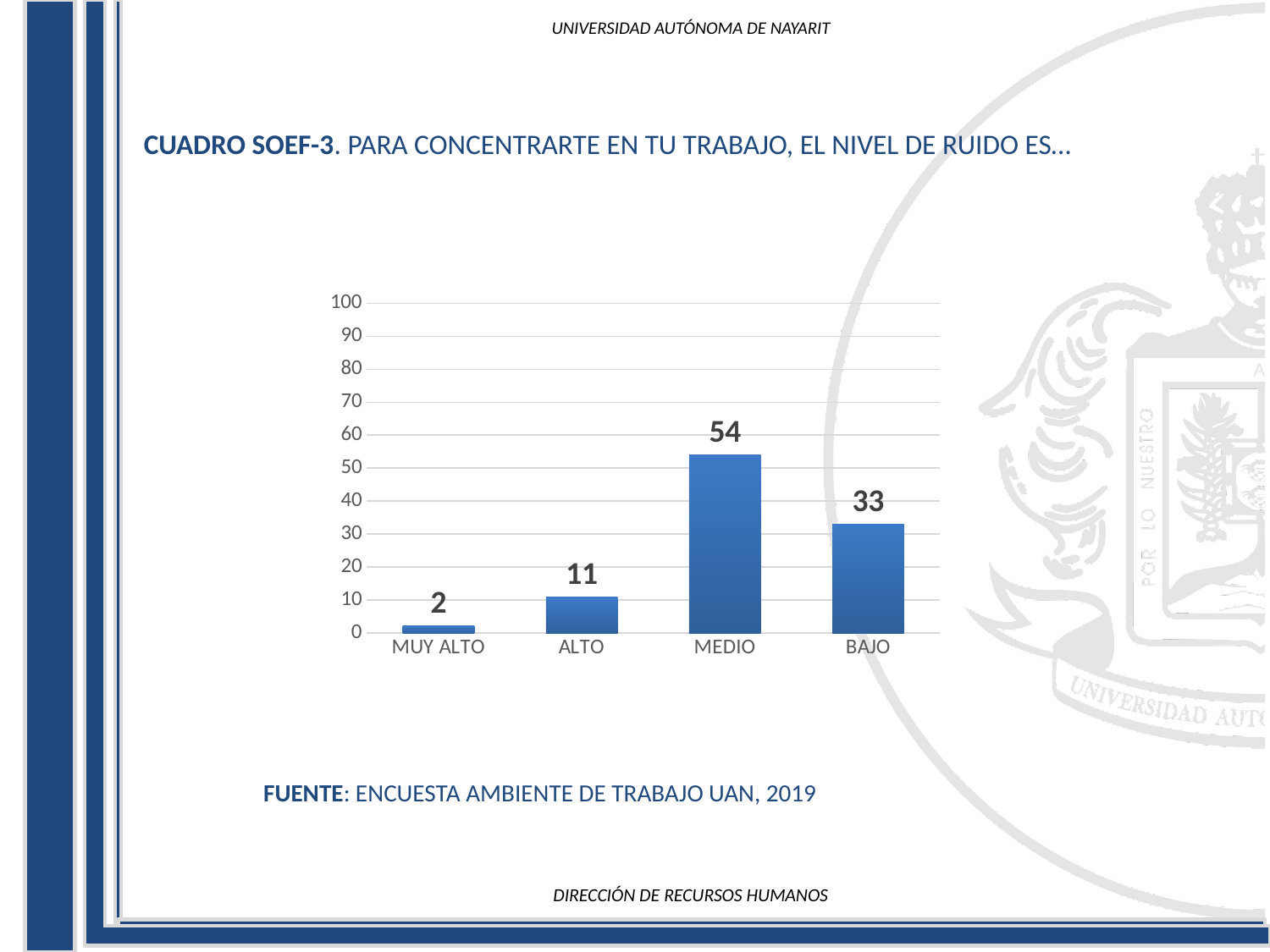
What is the value for ALTO? 11 What is the value for MUY ALTO? 2 What is the value for BAJO? 33 What is the value for MEDIO? 54 What is the source cited below the chart? ENCUESTA AMBIENTE DE TRABAJO UAN, 2019 What kind of chart is shown on the slide? bar chart Is the value for MEDIO greater or less than 50? greater Which category has the lowest value? MUY ALTO Which is larger, the value for ALTO or the value for BAJO? BAJO How many categories are shown on the x axis? 4 Which category has the highest value? MEDIO What is the difference between the values for MEDIO and BAJO? 21